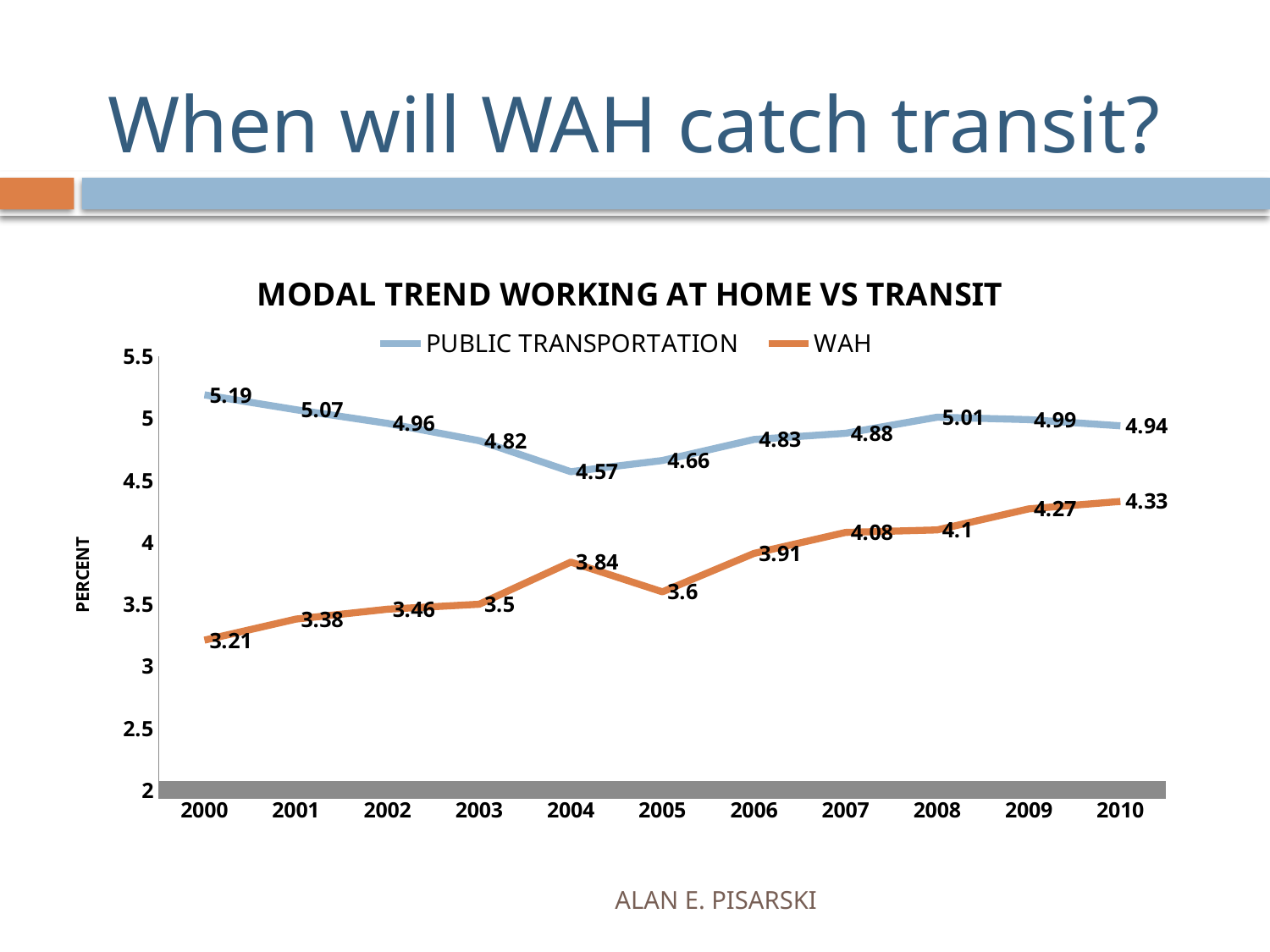
In which year is the PUBLIC TRANSPORTATION value lowest? 2004 What is the value for WAH in 2010? 4.33 How many years are shown on the x axis? 11 What kind of chart is shown? line chart How many series does the legend list? 2 What is the difference between the WAH values in 2000 and 2010? 1.12 What is the difference between PUBLIC TRANSPORTATION and WAH in 2010? 0.61 Which is larger in 2005, the PUBLIC TRANSPORTATION value or the WAH value? PUBLIC TRANSPORTATION What is the value for WAH in 2004? 3.84 Does the WAH series generally rise or fall from 2000 to 2010? rise In which year is the WAH value highest? 2010 What is the value for PUBLIC TRANSPORTATION in 2000? 5.19